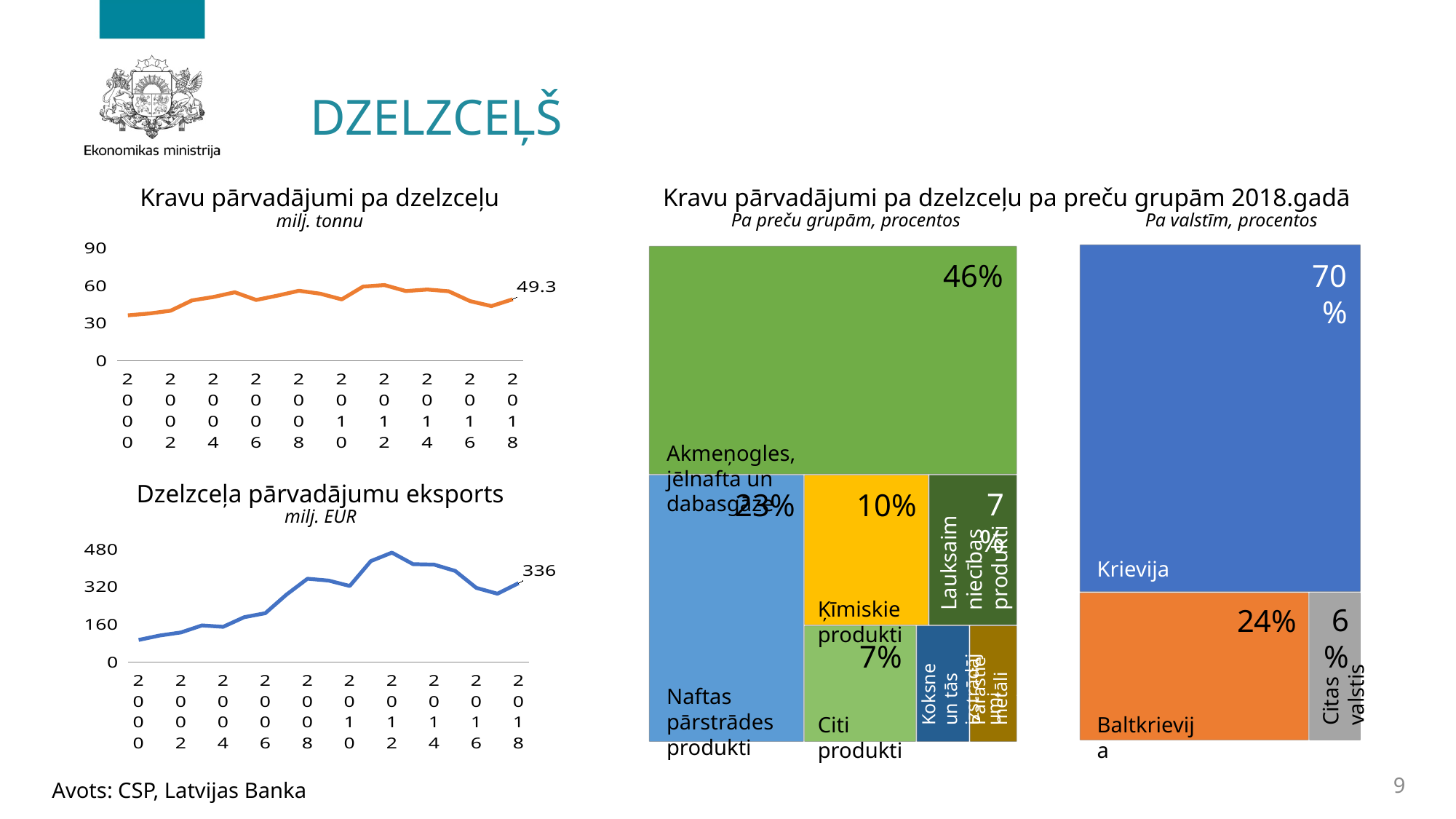
In the 'Pa preču grupām, procentos' chart, what share is shown for Akmeņogles, jēlnafta un dabasgāze? 46% In the 'Kravu pārvadājumi pa dzelzceļu' line chart, what value is labelled for 2018? 49.3 In the 'Pa valstīm, procentos' chart, what share is shown for Krievija? 70% In the 'Dzelzceļa pārvadājumu eksports' line chart, what value is labelled for 2018? 336 In the 'Pa valstīm, procentos' chart, which country has the largest share? Krievija What kind of chart is 'Kravu pārvadājumi pa dzelzceļu'? Line chart In the 'Kravu pārvadājumi pa dzelzceļu' chart, is the value for 2000 greater or less than 60? less In the 'Pa preču grupām, procentos' chart, what share is shown for Ķīmiskie produkti? 10% In the 'Pa valstīm, procentos' chart, how many percentage points larger is Krievija's share than Baltkrievija's? 46% In the 'Pa preču grupām, procentos' chart, which is larger: Naftas pārstrādes produkti or Ķīmiskie produkti? Naftas pārstrādes produkti In the 'Pa valstīm, procentos' chart, what share is shown for Citas valstis? 6% In the 'Pa valstīm, procentos' chart, what share is shown for Baltkrievija? 24%